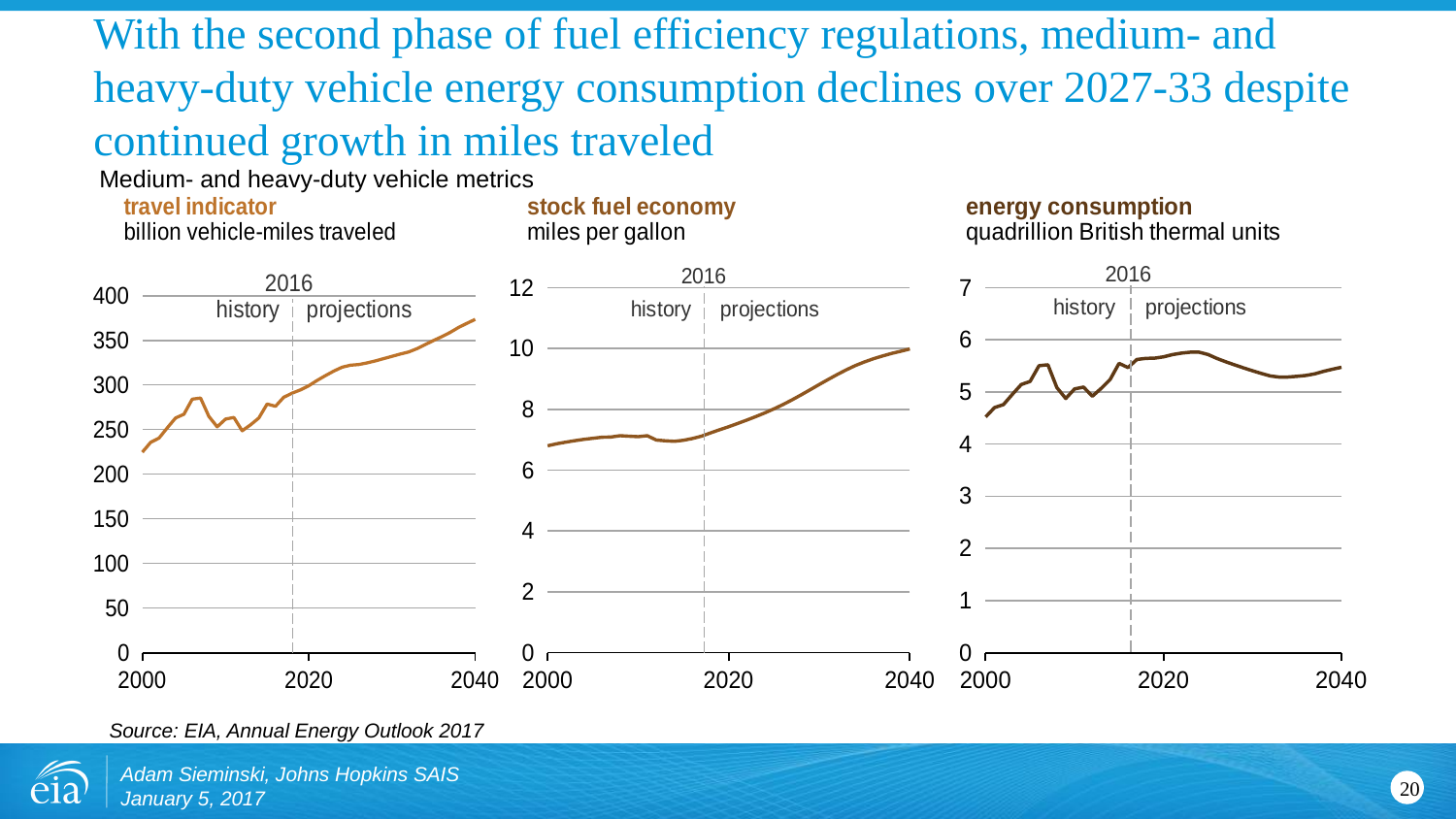
What unit is used on the energy consumption chart? quadrillion British thermal units In the travel indicator chart, do the values generally rise or fall from 2000 to 2040? rise In the stock fuel economy chart, is the value for 2000 greater or less than 8? less In the travel indicator chart, is the value for 2000 greater or less than 250? less How many charts are shown on the slide? 3 What kind of chart is the travel indicator chart? line chart In the energy consumption chart, is the highest value on the line greater or less than 6? less Which year does the dashed vertical line separating history from projections mark in each chart? 2016 In the stock fuel economy chart, do the values rise or fall over the projection period? rise